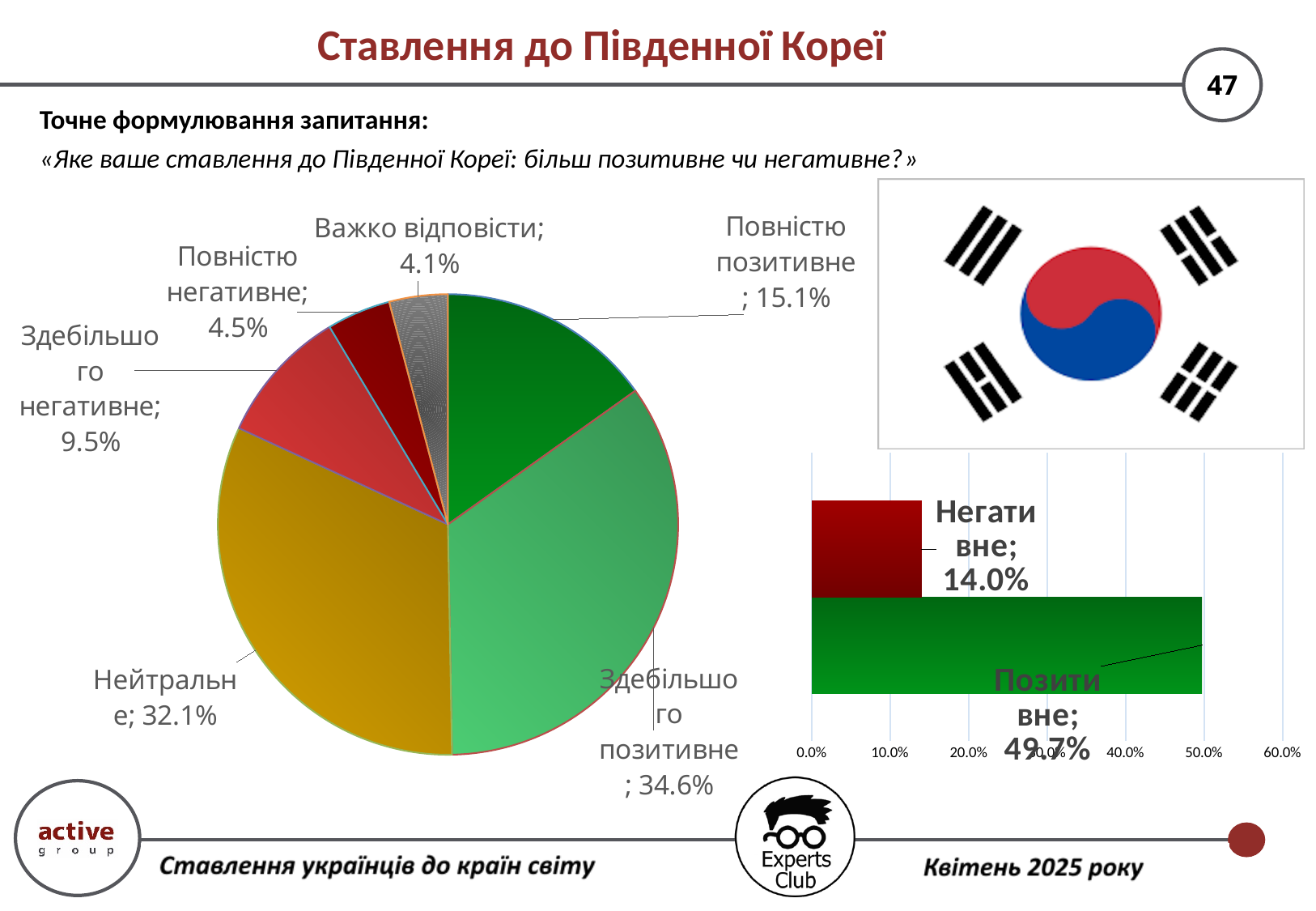
In the bar chart on the right, what is the difference between "Позитивне" and "Негативне"? 35.7% In the pie chart on the left, what is the difference between "Здебільшого негативне" and "Повністю негативне"? 5.0% In the pie chart on the left, which category has the smallest share? Важко відповісти In the pie chart on the left, which category has the largest share? Здебільшого позитивне In the bar chart on the right, what is the value for "Позитивне"? 49.7% In the pie chart on the left, what share of respondents answered "Здебільшого позитивне"? 34.6% How many categories does the pie chart on the left show? 6 In the pie chart on the left, what share of respondents answered "Нейтральне"? 32.1% In the pie chart on the left, what share of respondents answered "Важко відповісти"? 4.1% What type of chart is shown on the right side of the slide? Bar chart In the pie chart on the left, which is larger: "Повністю позитивне" or "Здебільшого негативне"? Повністю позитивне In the bar chart on the right, what is the value for "Негативне"? 14.0%